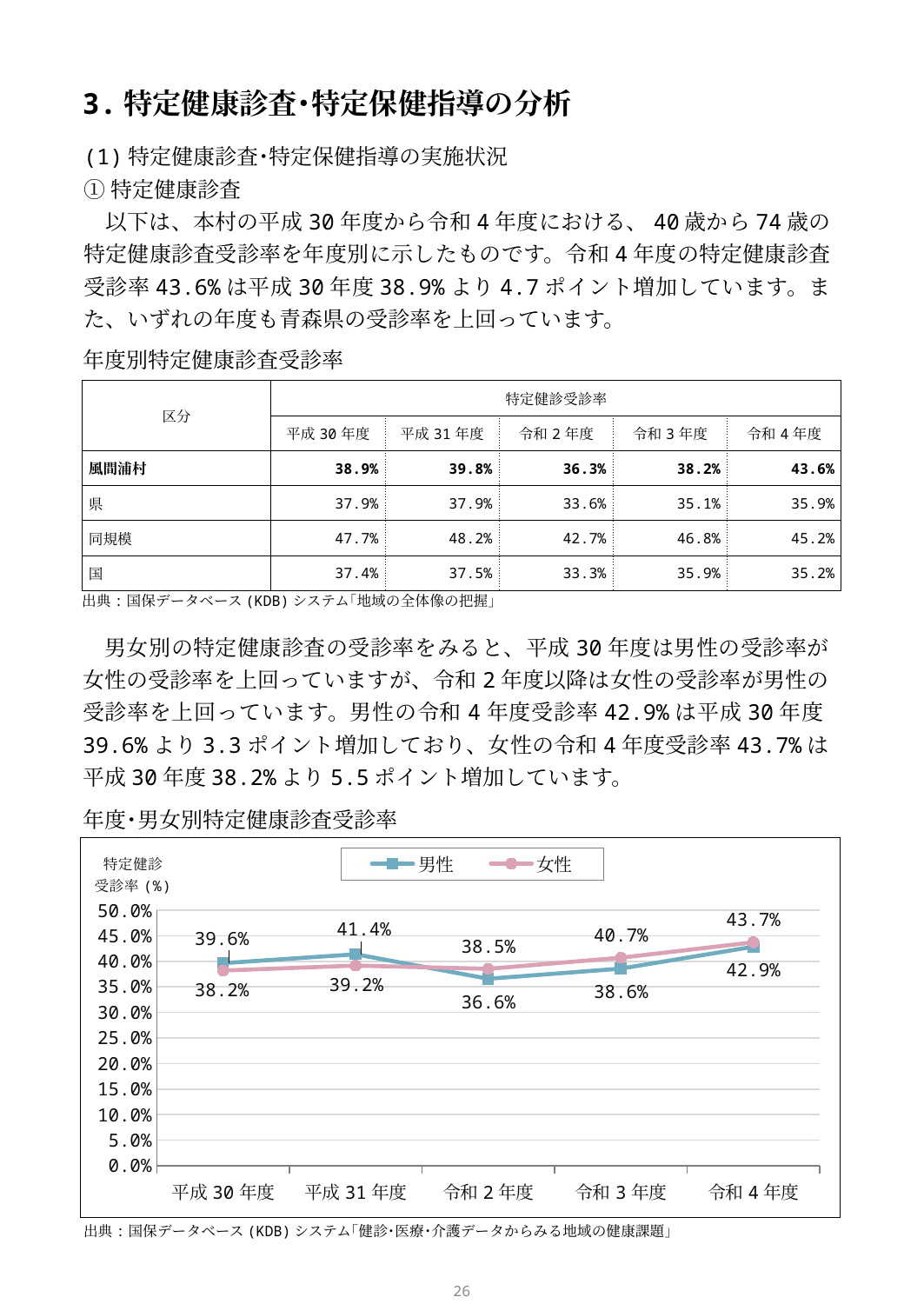
What kind of chart is 年度・男女別特定健康診査受診率? Line chart In the chart 年度・男女別特定健康診査受診率, which is larger in 令和3年度, 男性 or 女性? 女性 How many series does the legend of the chart 年度・男女別特定健康診査受診率 list? 2 In the chart 年度・男女別特定健康診査受診率, which is larger in 平成31年度, 男性 or 女性? 男性 In the chart 年度・男女別特定健康診査受診率, what is the value for 女性 in 令和3年度? 40.7% In the chart 年度・男女別特定健康診査受診率, what is the value for 女性 in 令和4年度? 43.7% In the chart 年度・男女別特定健康診査受診率, in which year is the 男性 value lowest? 令和2年度 In the chart 年度・男女別特定健康診査受診率, what is the value for 男性 in 平成30年度? 39.6% In the chart 年度・男女別特定健康診査受診率, what is the difference between the 男性 value in 令和4年度 and in 平成30年度? 3.3 points In the chart 年度・男女別特定健康診査受診率, what is the value for 男性 in 令和2年度? 36.6% How many fiscal years are shown on the x axis of the chart 年度・男女別特定健康診査受診率? 5 In the chart 年度・男女別特定健康診査受診率, in which year is the 男性 value highest? 令和4年度